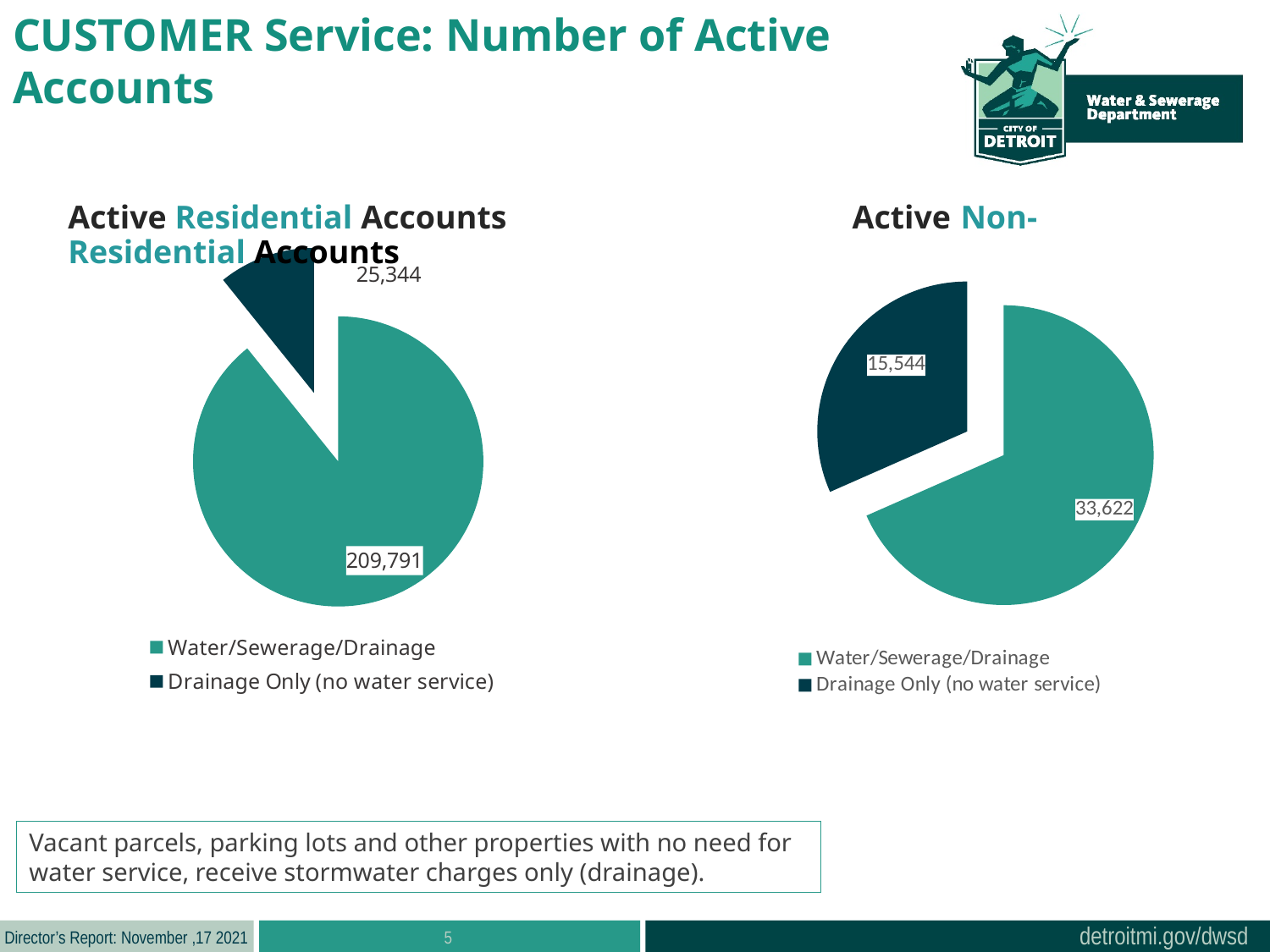
In the Active Residential Accounts chart, what is the difference between the Water/Sewerage/Drainage and Drainage Only values? 184,447 In the Active Residential Accounts chart, how many Drainage Only (no water service) accounts are there? 25,344 In the Active Non-Residential Accounts chart, how many Water/Sewerage/Drainage accounts are there? 33,622 In the Active Non-Residential Accounts chart, what is the difference between the Water/Sewerage/Drainage and Drainage Only values? 18,078 What is the total number of accounts shown in the Active Residential Accounts chart? 235,135 In the Active Non-Residential Accounts chart, how many Drainage Only (no water service) accounts are there? 15,544 Which is larger: the Drainage Only value in the Active Residential Accounts chart or the Drainage Only value in the Active Non-Residential Accounts chart? Active Residential Accounts What is the total number of accounts shown in the Active Non-Residential Accounts chart? 49,166 In the Active Residential Accounts chart, how many Water/Sewerage/Drainage accounts are there? 209,791 In the Active Non-Residential Accounts chart, which category has the smallest slice? Drainage Only (no water service) In the Active Residential Accounts chart, which category has the largest slice? Water/Sewerage/Drainage What type of chart is used for the Active Non-Residential Accounts? Pie chart